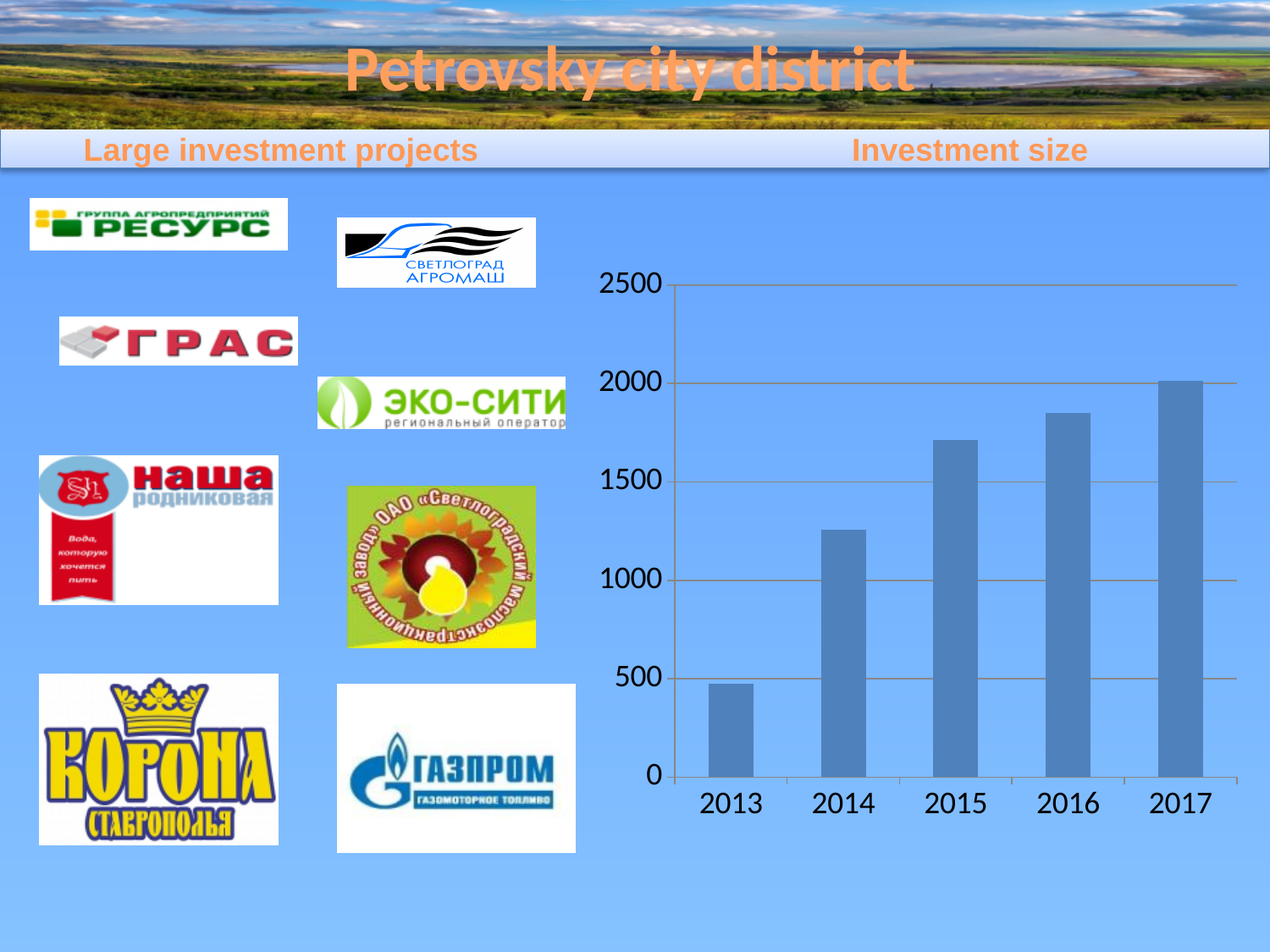
What is the heading above the bar chart on the right side of the slide? Investment size Which year has the lowest bar in the Investment size chart? 2013 How many years are shown on the x axis of the Investment size chart? 5 In the Investment size chart, is the value for 2013 greater or less than 1000? less In the Investment size chart, is the value for 2014 greater or less than 1000? greater Which year has the highest bar in the Investment size chart? 2017 In the Investment size chart, is the value for 2015 greater or less than 1500? greater In the Investment size chart, which year has the larger value, 2014 or 2015? 2015 Do the values in the Investment size chart rise or fall from 2013 to 2017? rise What kind of chart is shown under the heading "Investment size"? bar chart